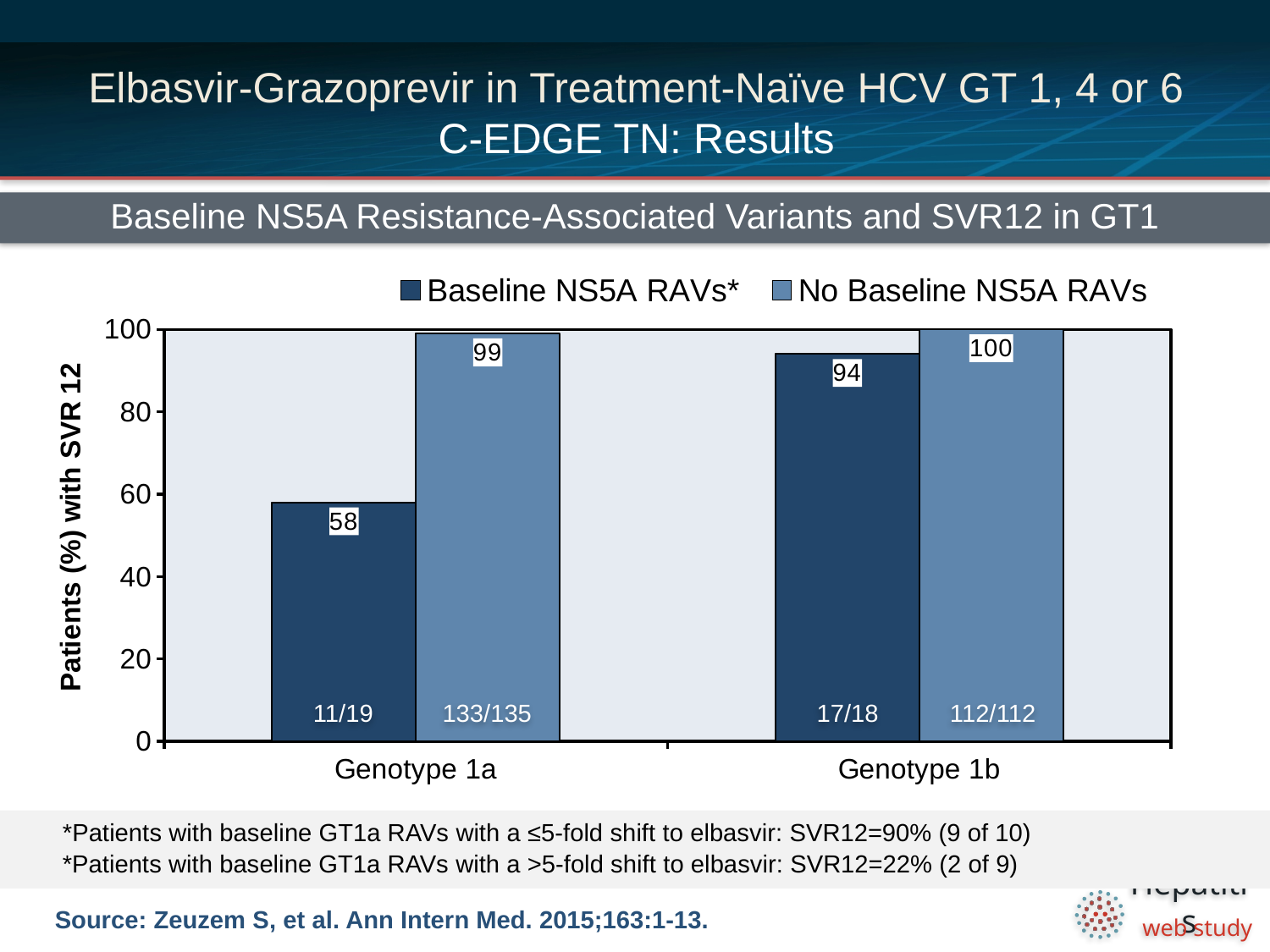
Which bar shows the lowest SVR12 rate? Genotype 1a, Baseline NS5A RAVs How many genotype categories are shown on the x axis? 2 How many series does the legend list? 2 What kind of chart is shown on the slide? Bar chart Is the SVR12 rate for Genotype 1a patients with baseline NS5A RAVs greater or less than 60? less What is the SVR12 rate for Genotype 1a patients with baseline NS5A RAVs? 58 What is the SVR12 rate for Genotype 1b patients with no baseline NS5A RAVs? 100 Which is larger: the SVR12 rate for Genotype 1a with baseline NS5A RAVs or for Genotype 1b with baseline NS5A RAVs? Genotype 1b with baseline NS5A RAVs What is the SVR12 rate for Genotype 1a patients with no baseline NS5A RAVs? 99 Which bar shows the highest SVR12 rate? Genotype 1b, No Baseline NS5A RAVs What fraction of Genotype 1b patients with baseline NS5A RAVs achieved SVR12? 17/18 What is the difference in SVR12 rate between Genotype 1a patients with and without baseline NS5A RAVs? 41